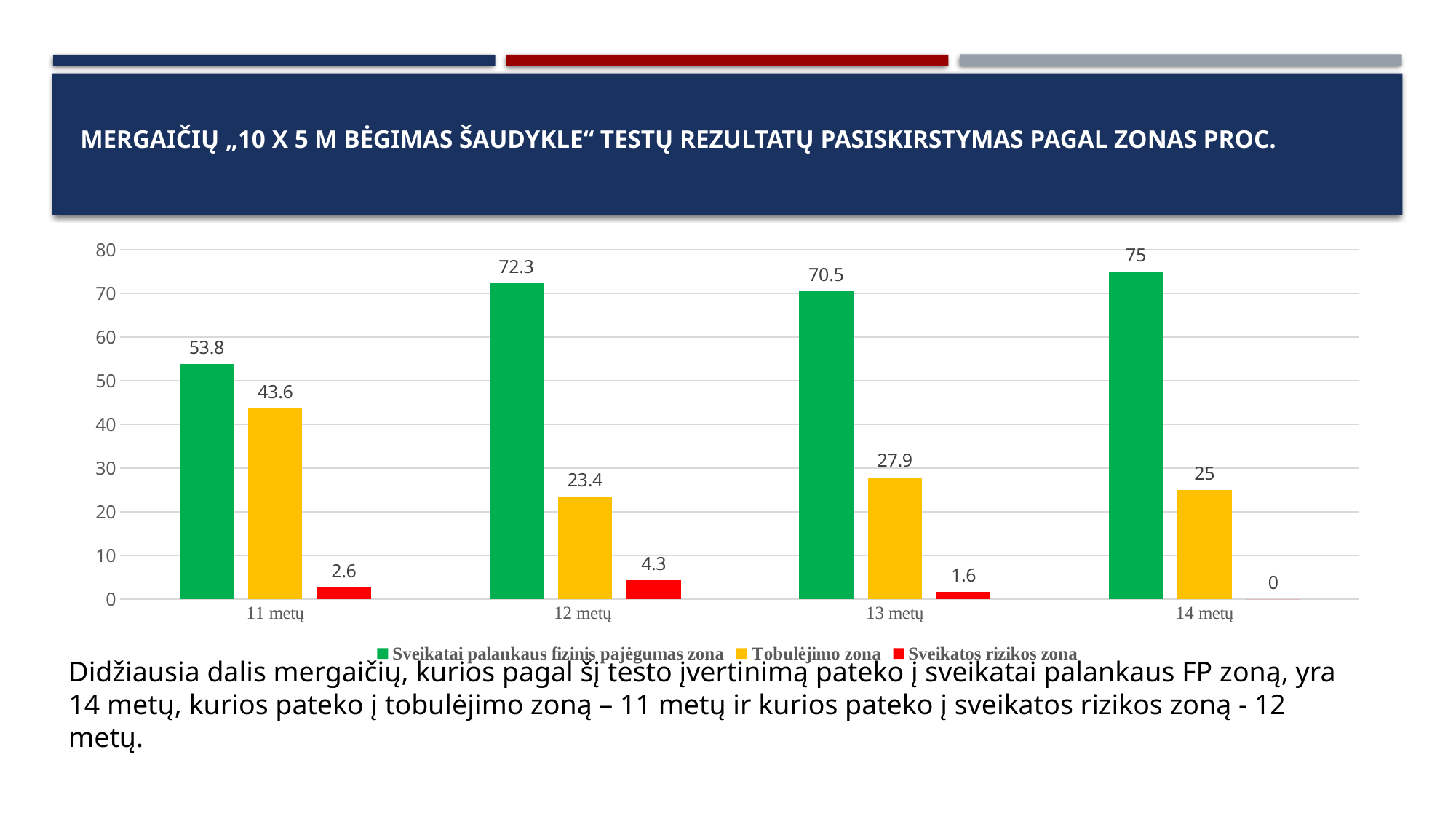
What is the value for 'Tobulėjimo zona' for 11 metų? 43.6 Which colour represents 'Sveikatos rizikos zona' in the chart? red Which age group has the lowest value for 'Tobulėjimo zona'? 12 metų Which is larger: the 'Sveikatos rizikos zona' value for 12 metų or for 13 metų? 12 metų What is the value for 'Sveikatai palankaus fizinis pajėgumas zona' for 12 metų? 72.3 Which age group has the highest value for 'Sveikatai palankaus fizinis pajėgumas zona'? 14 metų What kind of chart is shown on the slide? bar chart How many age groups are shown on the x axis? 4 How many series does the legend list? 3 What is the difference between the 'Sveikatai palankaus fizinis pajėgumas zona' values for 14 metų and 11 metų? 21.2 What is the value for 'Sveikatos rizikos zona' for 14 metų? 0 Is the 'Sveikatai palankaus fizinis pajėgumas zona' value for 13 metų greater or less than 60? greater